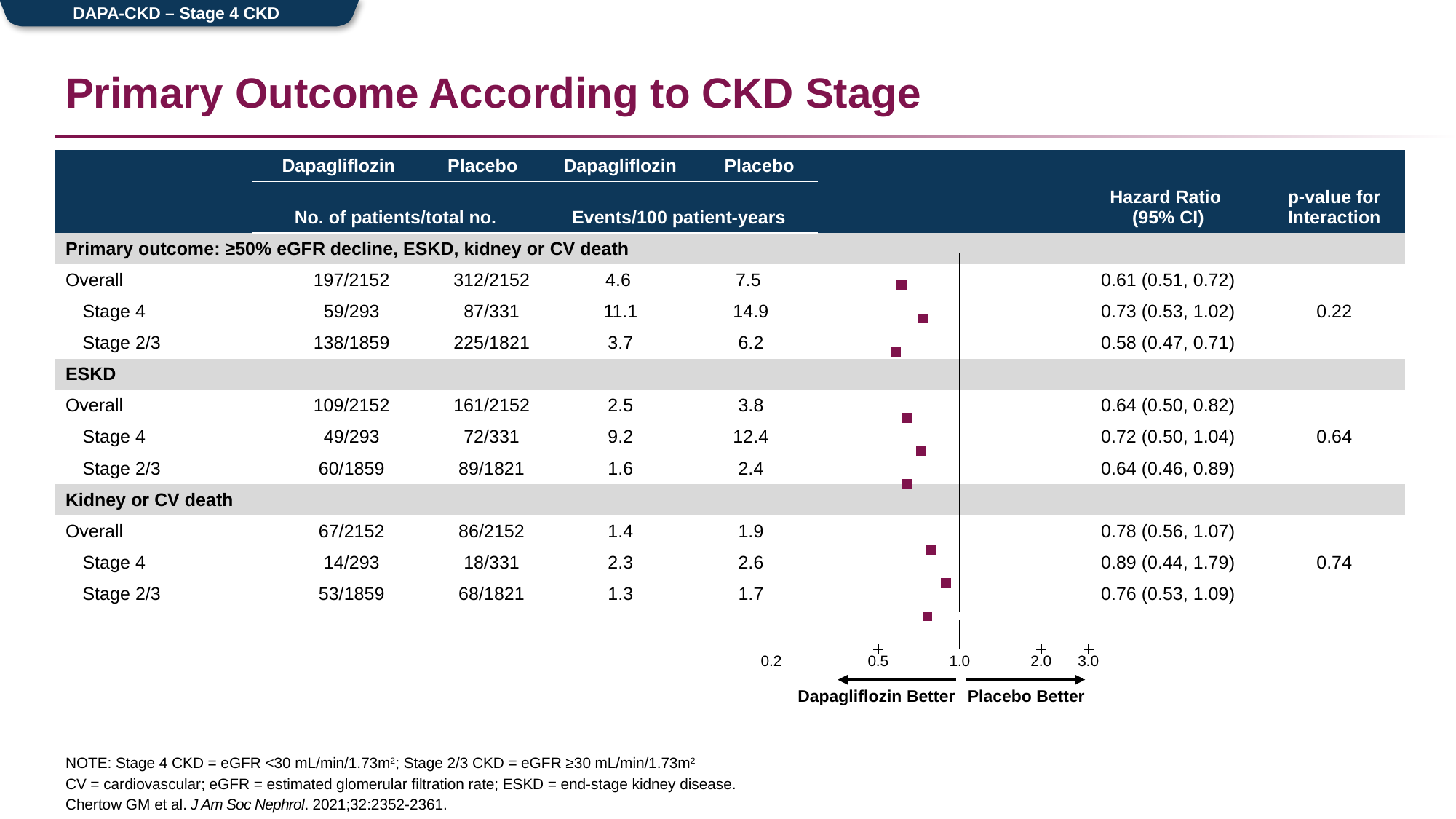
For the primary outcome, which has the larger hazard ratio: Stage 4 or Stage 2/3? Stage 4 What is the hazard ratio (95% CI) for Stage 4 patients for the ESKD outcome? 0.72 (0.50, 1.04) What is the number of patients/total no. for dapagliflozin in Stage 4 for the primary outcome? 59/293 What is the hazard ratio (95% CI) for the Overall group for the primary outcome? 0.61 (0.51, 0.72) What kind of chart is shown on the slide? Forest plot Which subgroup and outcome has the lowest hazard ratio in the forest plot? Stage 2/3, primary outcome (0.58) What label appears on the left side of the axis arrow below the forest plot? Dapagliflozin Better For Stage 4 patients in the primary outcome, what is the difference in events/100 patient-years between placebo and dapagliflozin? 3.8 How many hazard ratio points are plotted in the forest plot? 9 Which subgroup and outcome has the highest hazard ratio in the forest plot? Stage 4, Kidney or CV death (0.89) Is the hazard ratio for the Overall group for the primary outcome greater or less than 1.0? less What is the p-value for interaction for the ESKD outcome? 0.64